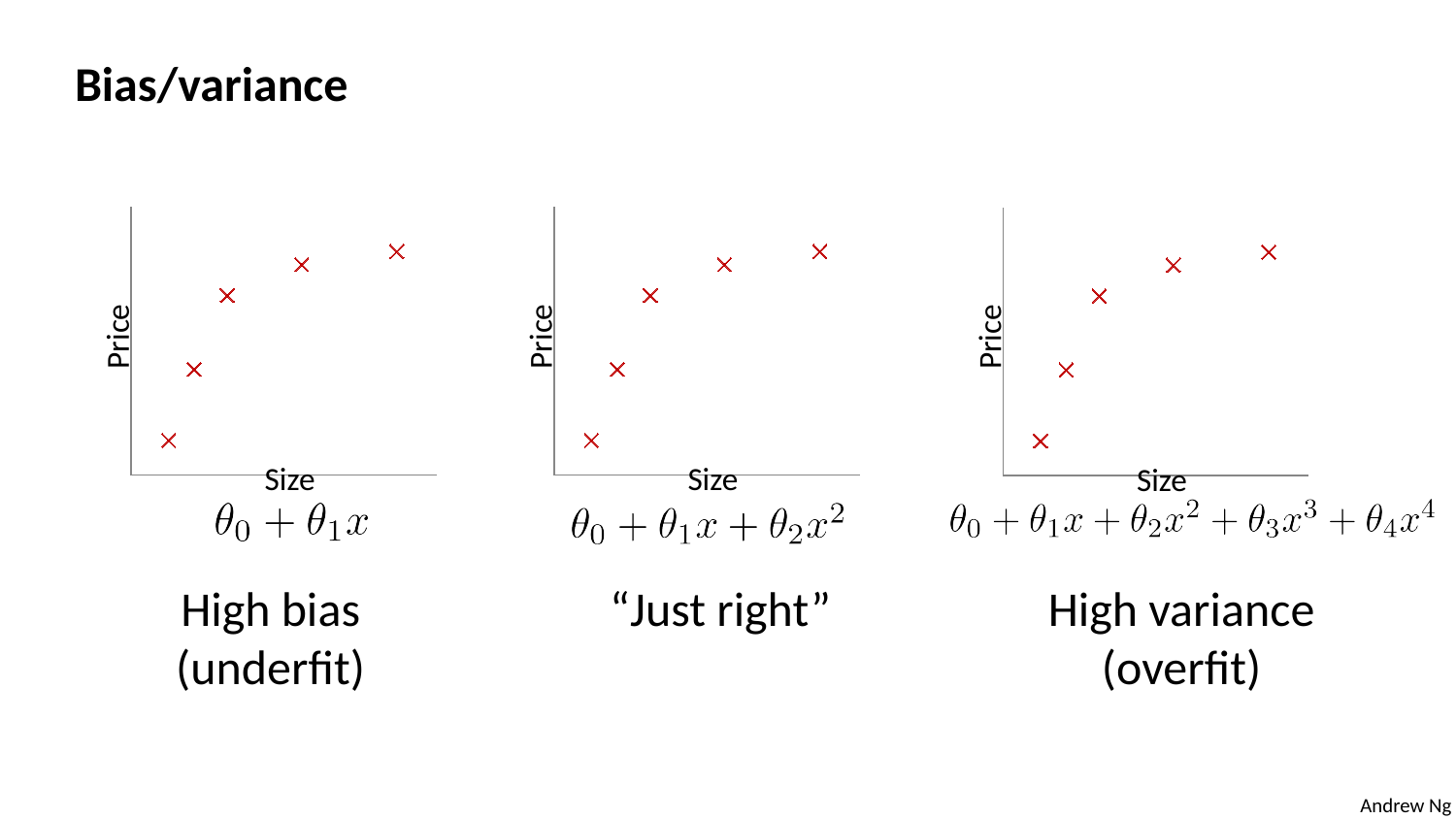
How many charts are shown on the slide? 3 In the left-hand chart labelled "High bias (underfit)", do the plotted values rise or fall as Size increases? rise In the middle chart labelled "Just right", is the point with the largest Size the highest or the lowest in Price? highest What is the label on the x axis of the middle chart labelled "Just right"? Size How many data points are plotted in the right-hand chart labelled "High variance (overfit)"? 5 How many data points are plotted in the middle chart labelled "Just right"? 5 What is the label on the y axis of the left-hand chart labelled "High bias (underfit)"? Price What kind of chart is the left-hand chart labelled "High bias (underfit)"? scatter plot In the right-hand chart labelled "High variance (overfit)", which point has the lowest Price: the one with the smallest Size or the one with the largest Size? the one with the smallest Size In the right-hand chart labelled "High variance (overfit)", do the plotted values rise or fall as Size increases? rise